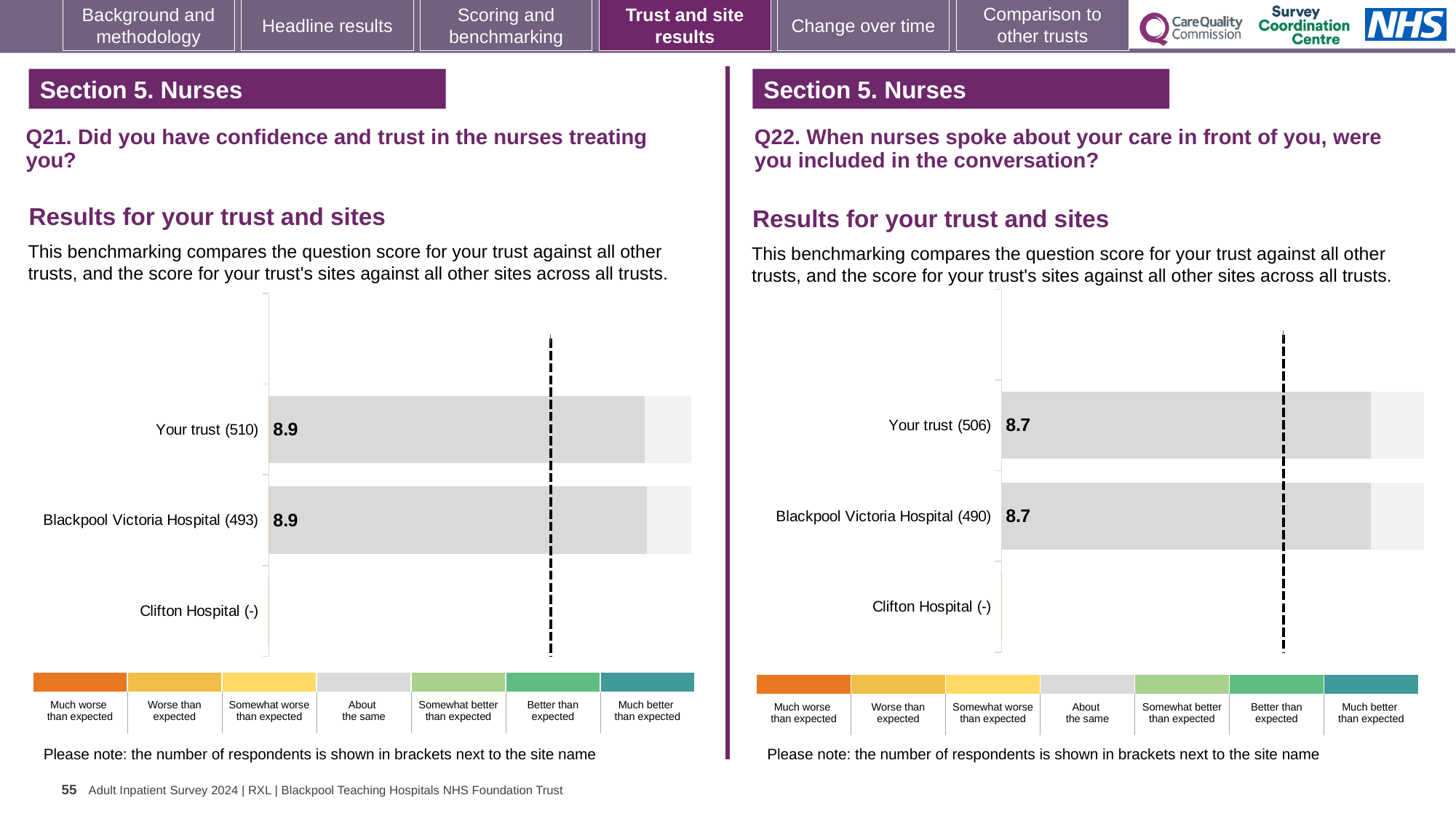
On the Q22 chart (right), what is the difference between the score for Your trust and the score for Blackpool Victoria Hospital? 0 On the Q22 chart (right), how many respondents are shown in brackets for Blackpool Victoria Hospital? 490 On the Q21 chart (left), what is the score for Your trust? 8.9 On the Q22 chart (right), what is the score for Your trust? 8.7 Is the score for Your trust on the Q21 chart (left) larger or smaller than the score for Your trust on the Q22 chart (right)? Larger On the Q22 chart (right), how many site or trust categories are listed on the vertical axis? 3 On the Q21 chart (left), how many site or trust categories are listed on the vertical axis? 3 On the Q21 chart (left), how many respondents are shown in brackets for Your trust? 510 On the Q21 chart (left), what is the difference between the score for Your trust and the score for Blackpool Victoria Hospital? 0 On the Q22 chart (right), what is the score for Blackpool Victoria Hospital? 8.7 On the Q21 chart (left), what is the score for Blackpool Victoria Hospital? 8.9 What kind of chart is the Q21 chart (left)? Bar chart